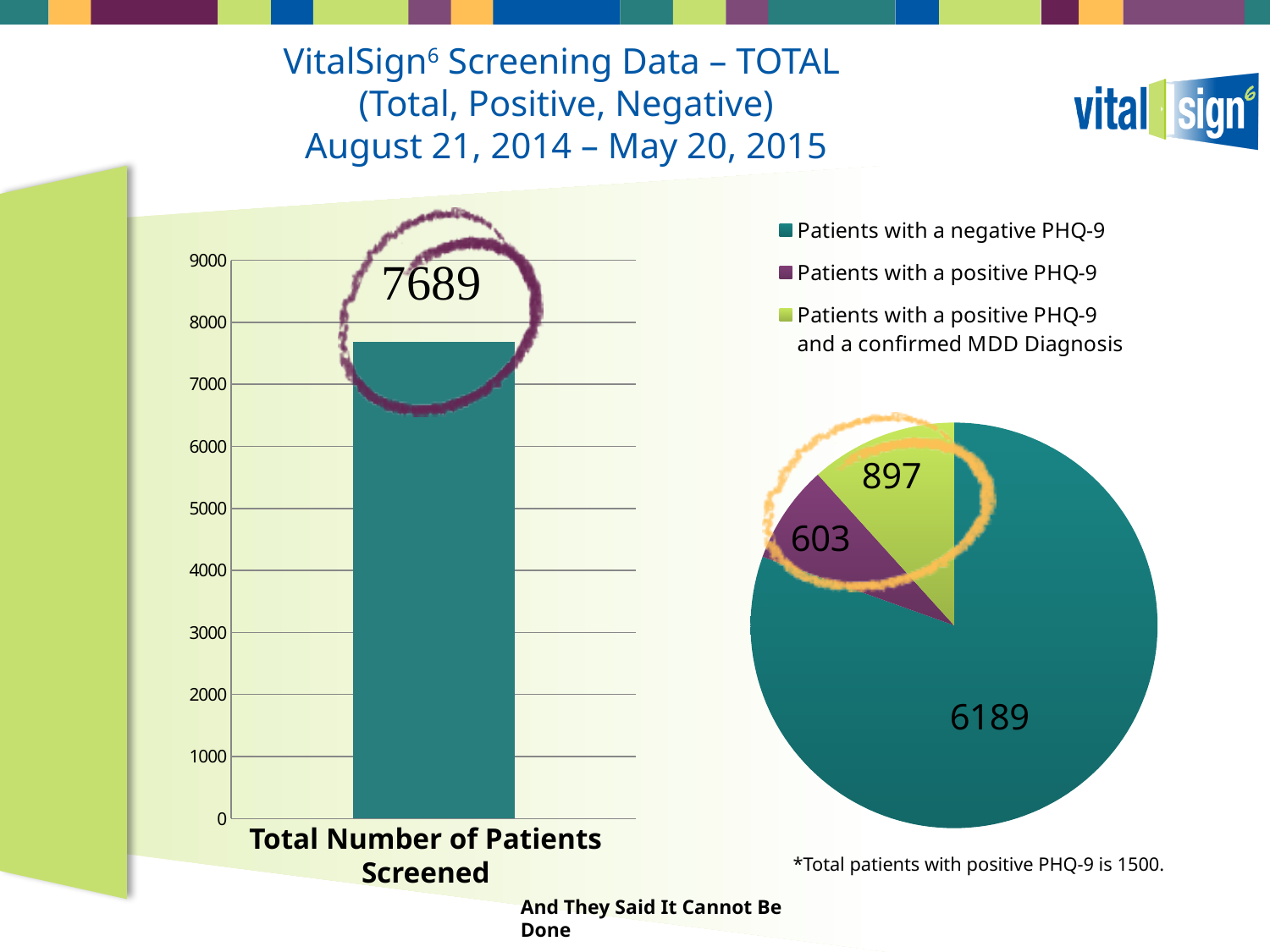
What kind of chart is the chart on the left of the slide? Bar chart In the bar chart on the left, is the value for Total Number of Patients Screened greater or less than 7000? greater In the pie chart on the right, what is the value for Patients with a negative PHQ-9? 6189 In the bar chart on the left, what is the value shown for Total Number of Patients Screened? 7689 How many slices does the pie chart on the right have? 3 In the pie chart on the right, which category has the largest slice? Patients with a negative PHQ-9 In the pie chart on the right, which is larger: Patients with a positive PHQ-9 or Patients with a positive PHQ-9 and a confirmed MDD Diagnosis? Patients with a positive PHQ-9 and a confirmed MDD Diagnosis In the pie chart on the right, which category has the smallest slice? Patients with a positive PHQ-9 How many entries does the legend of the pie chart on the right list? 3 In the pie chart on the right, what is the value for Patients with a positive PHQ-9 and a confirmed MDD Diagnosis? 897 In the pie chart on the right, what is the difference between the negative PHQ-9 value and the positive PHQ-9 with confirmed MDD Diagnosis value? 5292 In the pie chart on the right, what is the value for Patients with a positive PHQ-9? 603